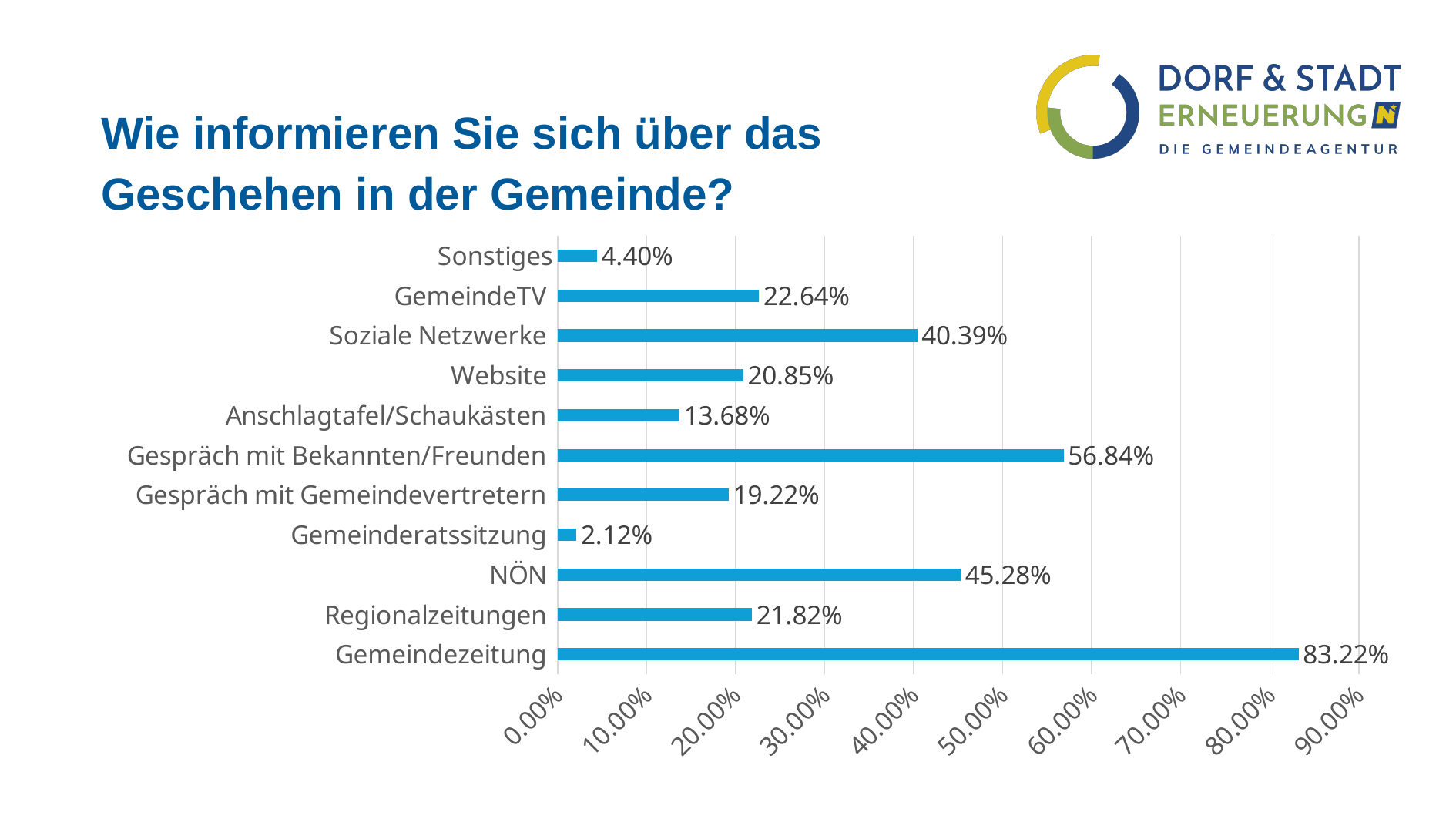
Which category has the highest value? Gemeindezeitung Which category has the lowest value? Gemeinderatssitzung What is the value for Gemeindezeitung? 83.22% What is the value for Soziale Netzwerke? 40.39% What is the difference between the values for NÖN and Regionalzeitungen? 23.46% What is the value for Gespräch mit Gemeindevertretern? 19.22% What kind of chart is shown on the slide? bar chart What is the difference between the values for Gemeindezeitung and Gespräch mit Bekannten/Freunden? 26.38% How many categories are shown in the chart? 11 What is the title of the slide containing the chart? Wie informieren Sie sich über das Geschehen in der Gemeinde? Is the value for Gespräch mit Bekannten/Freunden greater or less than 50.00%? greater Which is larger, the value for GemeindeTV or the value for Website? GemeindeTV